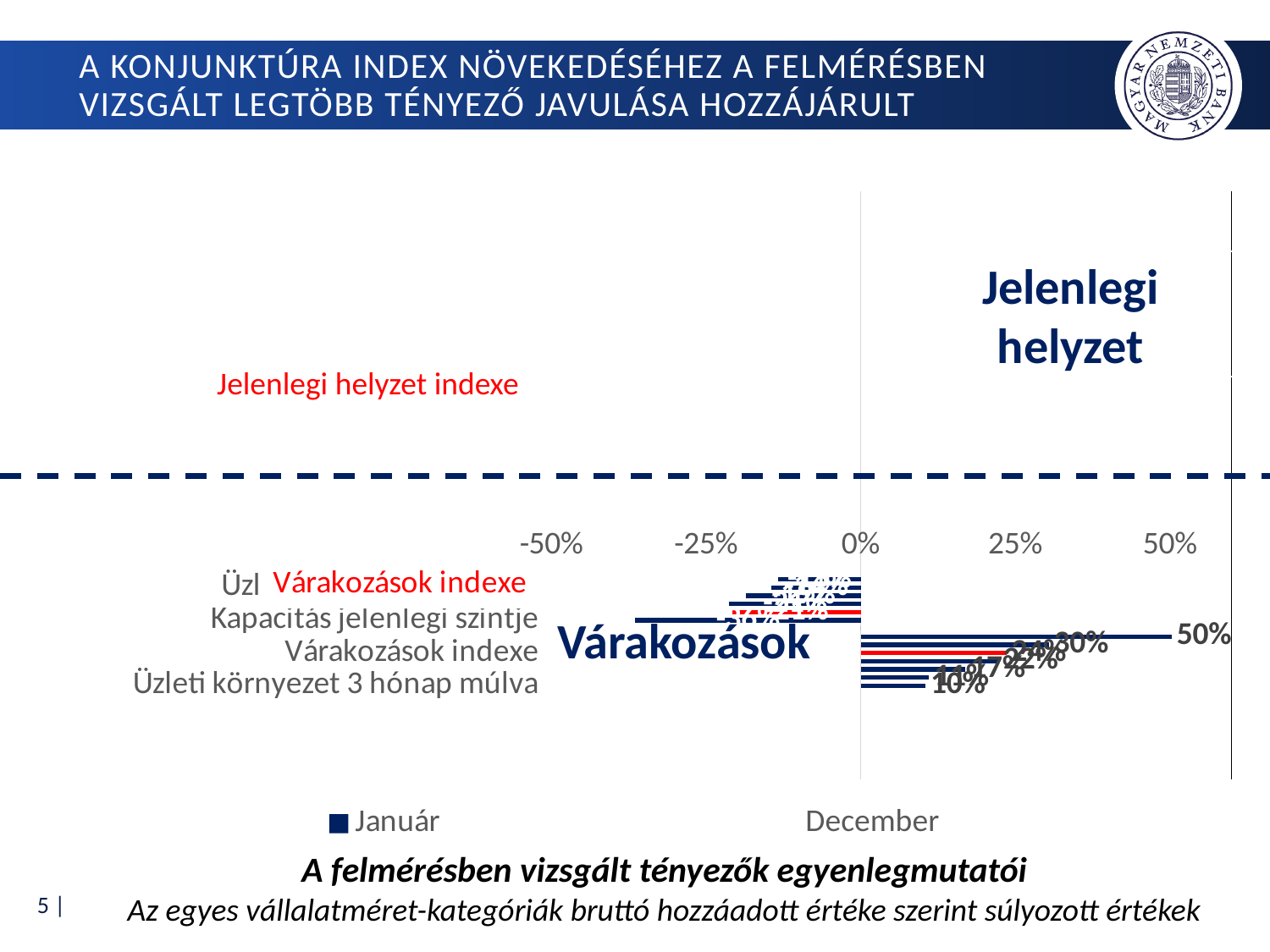
What are the two series named in the chart legend? Január and December What kind of chart is shown on the slide? bar chart What is the highest value shown on the chart's x axis? 50% What is the largest data label printed on the chart? 50% How many series does the chart legend list? 2 Is the longest bar on the chart greater or less than 25%? greater Which series is shown in dark blue in the legend? Január